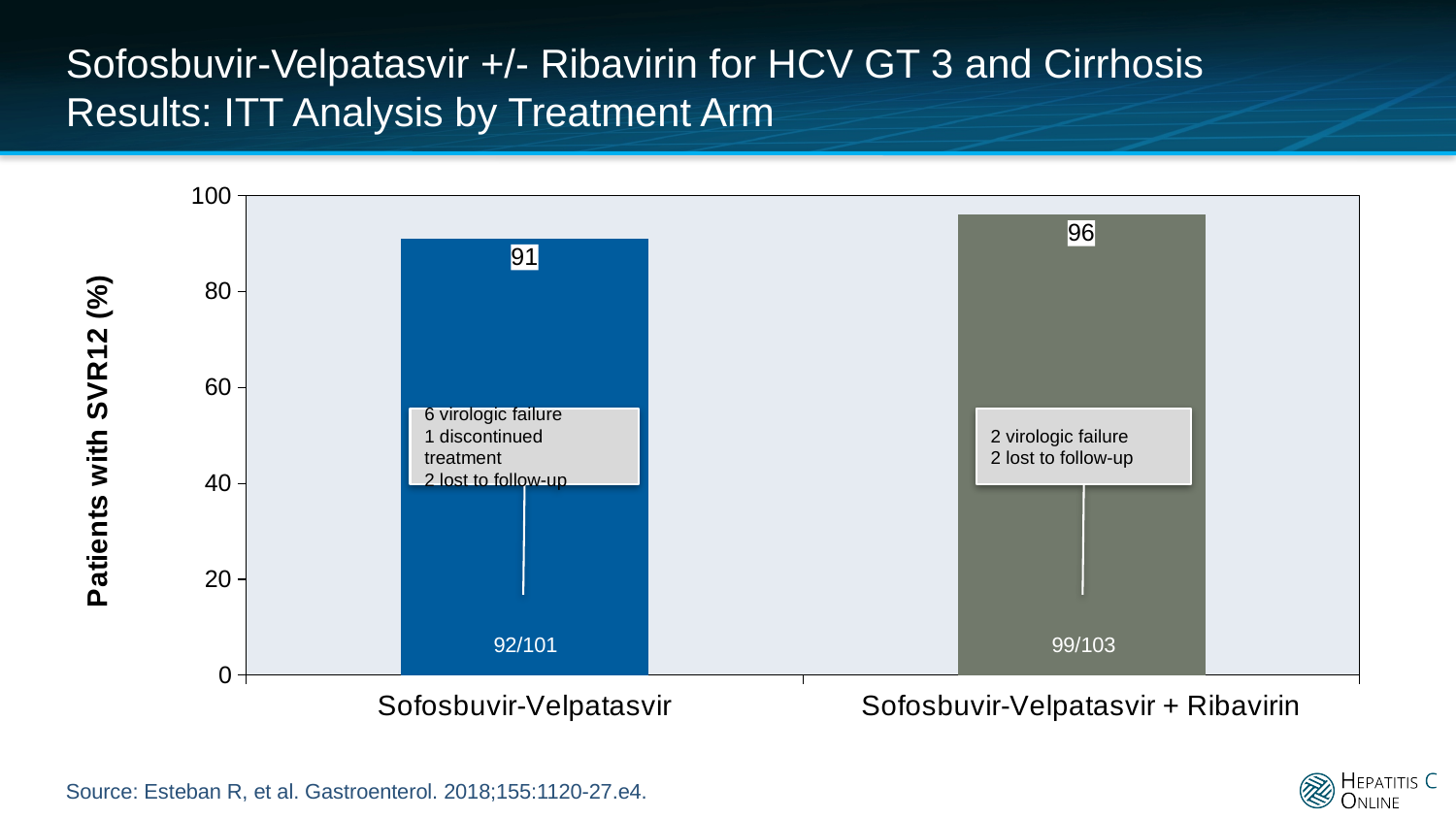
What is the SVR12 rate for Sofosbuvir-Velpatasvir? 91 Is the SVR12 rate for Sofosbuvir-Velpatasvir greater or less than 80? greater What is the SVR12 rate for Sofosbuvir-Velpatasvir + Ribavirin? 96 Which treatment arm has the highest SVR12 rate? Sofosbuvir-Velpatasvir + Ribavirin What is the difference in SVR12 rate between Sofosbuvir-Velpatasvir + Ribavirin and Sofosbuvir-Velpatasvir? 5 How many patients achieved SVR12 out of the total in the Sofosbuvir-Velpatasvir arm? 92/101 How many patients achieved SVR12 out of the total in the Sofosbuvir-Velpatasvir + Ribavirin arm? 99/103 How many treatment arms are shown in the chart? 2 What kind of chart is shown on the slide? Bar chart Which has a higher SVR12 rate, Sofosbuvir-Velpatasvir or Sofosbuvir-Velpatasvir + Ribavirin? Sofosbuvir-Velpatasvir + Ribavirin What is the label of the y-axis? Patients with SVR12 (%) Which treatment arm has the lowest SVR12 rate? Sofosbuvir-Velpatasvir